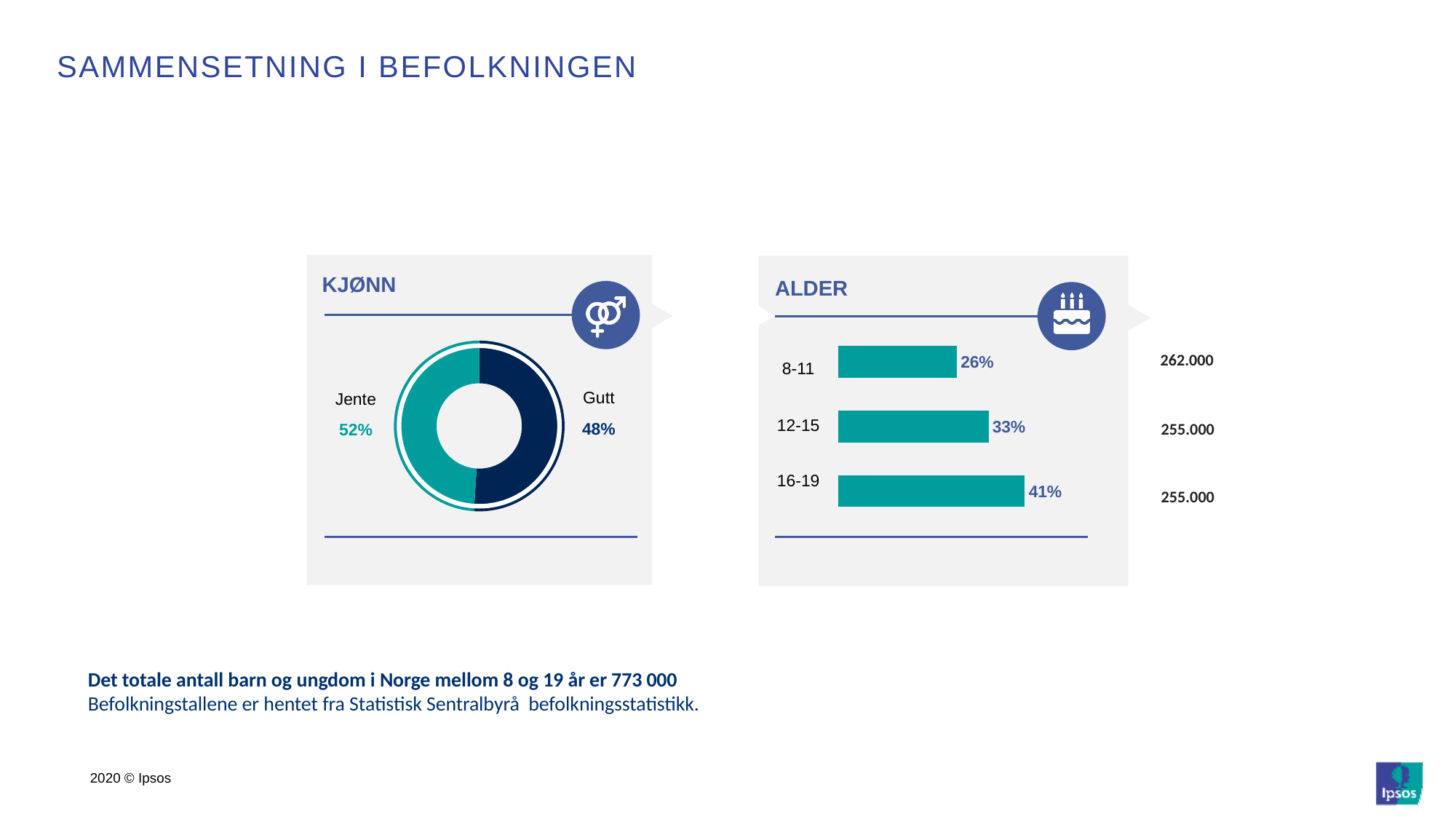
In the ALDER chart, which age group has the lowest percentage? 8-11 What kind of chart is the ALDER chart? Bar chart In the ALDER chart, which age group has the highest percentage? 16-19 In the KJØNN chart, which category has the larger share, Jente or Gutt? Jente In the ALDER chart, what is the difference in percentage points between the 16-19 and 12-15 age groups? 8 What kind of chart is the KJØNN chart? Donut (pie) chart In the ALDER chart, what percentage is shown for the 8-11 age group? 26% In the ALDER chart, what percentage is shown for the 16-19 age group? 41% How many age groups are shown in the ALDER chart? 3 In the KJØNN chart, what is the difference in percentage points between Jente and Gutt? 4 In the KJØNN chart, what percentage is shown for Gutt? 48% In the KJØNN chart, what percentage is shown for Jente? 52%